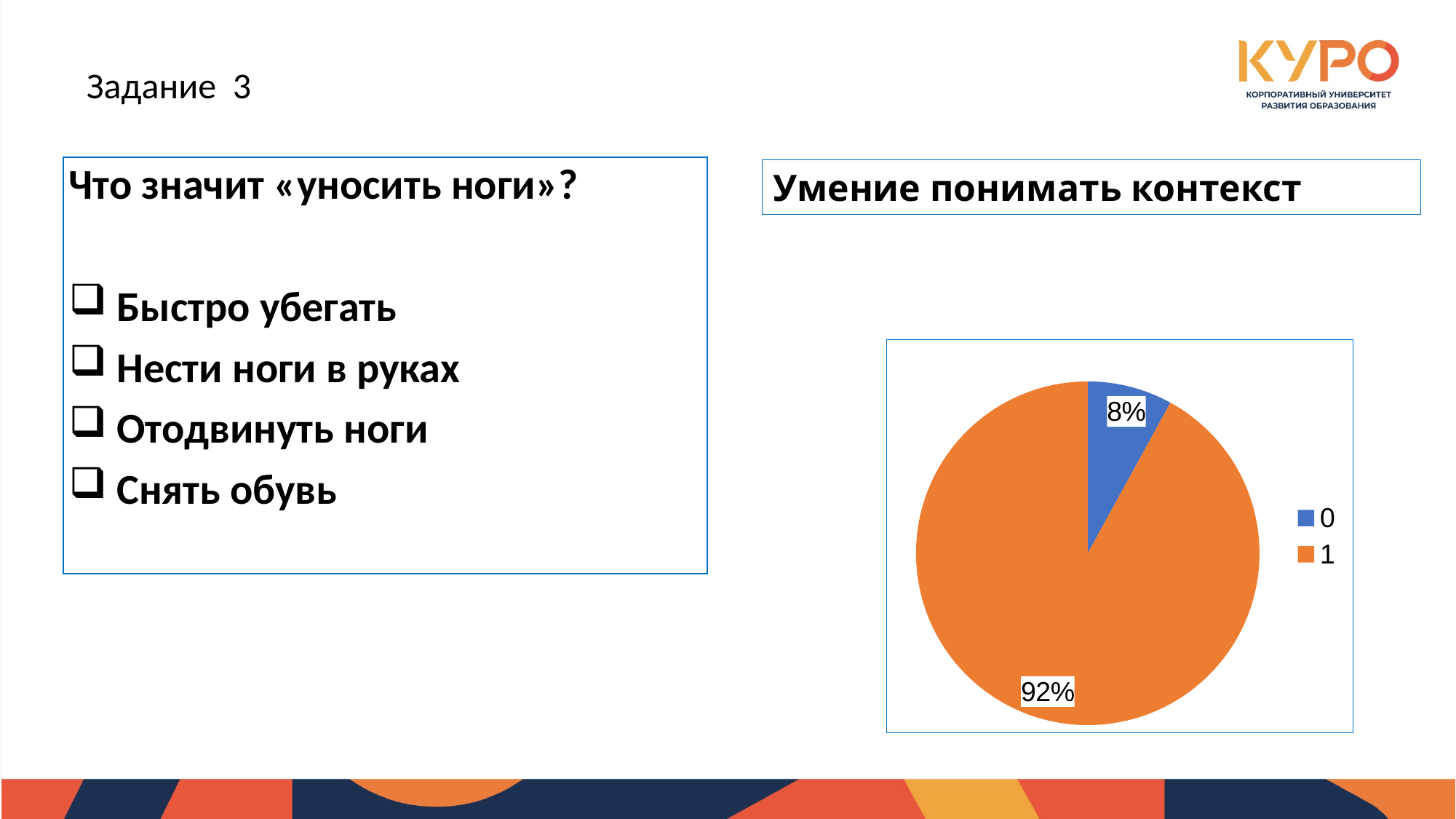
What percentage is shown for category 0 in the pie chart? 8% What share of the pie does category 1 take? 92% What colour is the slice for category 0? blue What is the difference in percentage points between the slices for 1 and 0? 84 Which category has the smallest slice in the pie chart? 0 Which slice is larger, 0 or 1? 1 Which category has the largest slice in the pie chart? 1 How many entries does the legend list? 2 How many slices does the pie chart have? 2 What percentage is shown for category 1 in the pie chart? 92% What kind of chart is shown on the slide? pie chart What colour is the slice for category 1? orange